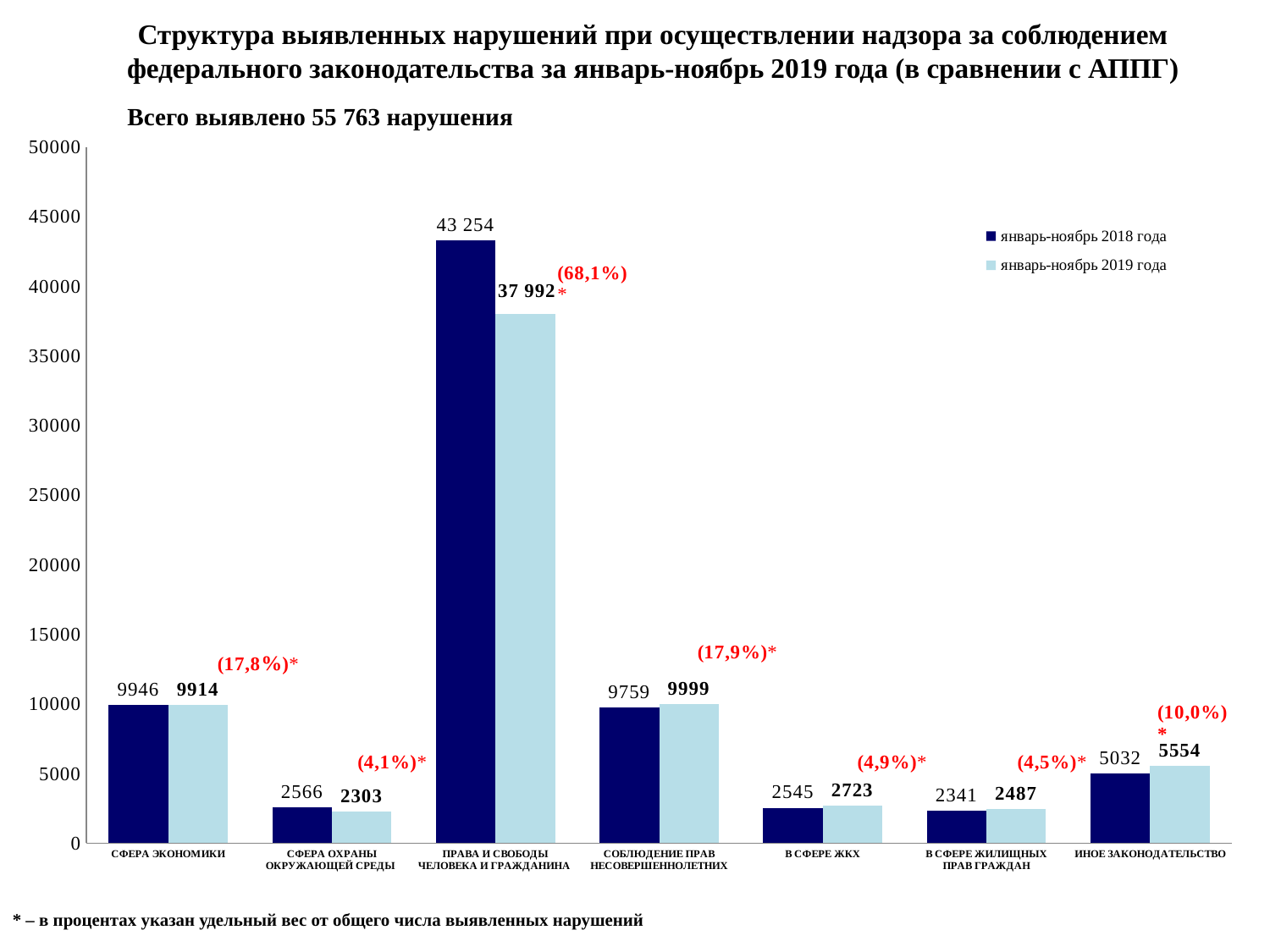
What share of the total number of violations does Права и свободы человека и гражданина account for in 2019, as printed on the slide? (68,1%) What is the difference between the 2018 and 2019 values for Права и свободы человека и гражданина? 5262 What is the value for Сфера экономики for январь-ноябрь 2018 года? 9946 What total number of violations is stated in the subtitle of the chart? 55 763 What type of chart is shown on the slide? bar chart How many series does the legend list? 2 What is the value for Иное законодательство for январь-ноябрь 2019 года? 5554 What is the value for Права и свободы человека и гражданина for январь-ноябрь 2019 года? 37 992 Which category has the lowest value for январь-ноябрь 2019 года? Сфера охраны окружающей среды Which is larger for Соблюдение прав несовершеннолетних: the value for январь-ноябрь 2018 года or for январь-ноябрь 2019 года? январь-ноябрь 2019 года Which category has the highest value for январь-ноябрь 2019 года? Права и свободы человека и гражданина How many categories are shown on the x axis of the chart? 7